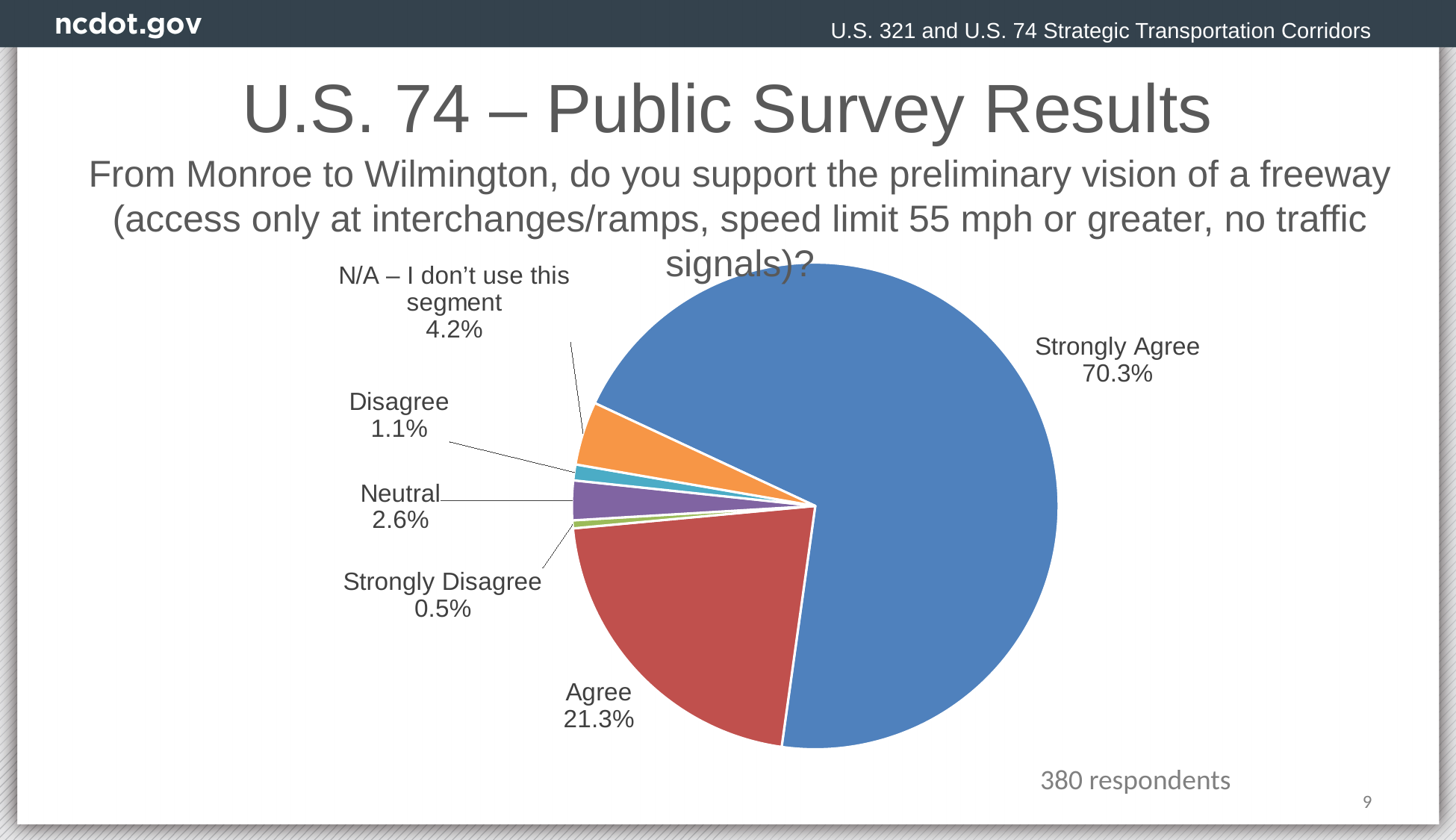
What kind of chart is shown on the slide? Pie chart What share of respondents answered Strongly Agree? 70.3% Which response has the smallest share of the pie? Strongly Disagree How many response categories are shown in the pie chart? 6 What is the combined share of Disagree and Strongly Disagree? 1.6% What is the difference in percentage points between Strongly Agree and Agree? 49.0 percentage points What share of respondents answered Agree? 21.3% Which is larger, the share for Disagree or the share for Neutral? Neutral How many respondents does the slide say took the survey? 380 respondents What share of respondents chose N/A – I don't use this segment? 4.2% Which response has the largest share of the pie? Strongly Agree What share of respondents answered Neutral? 2.6%